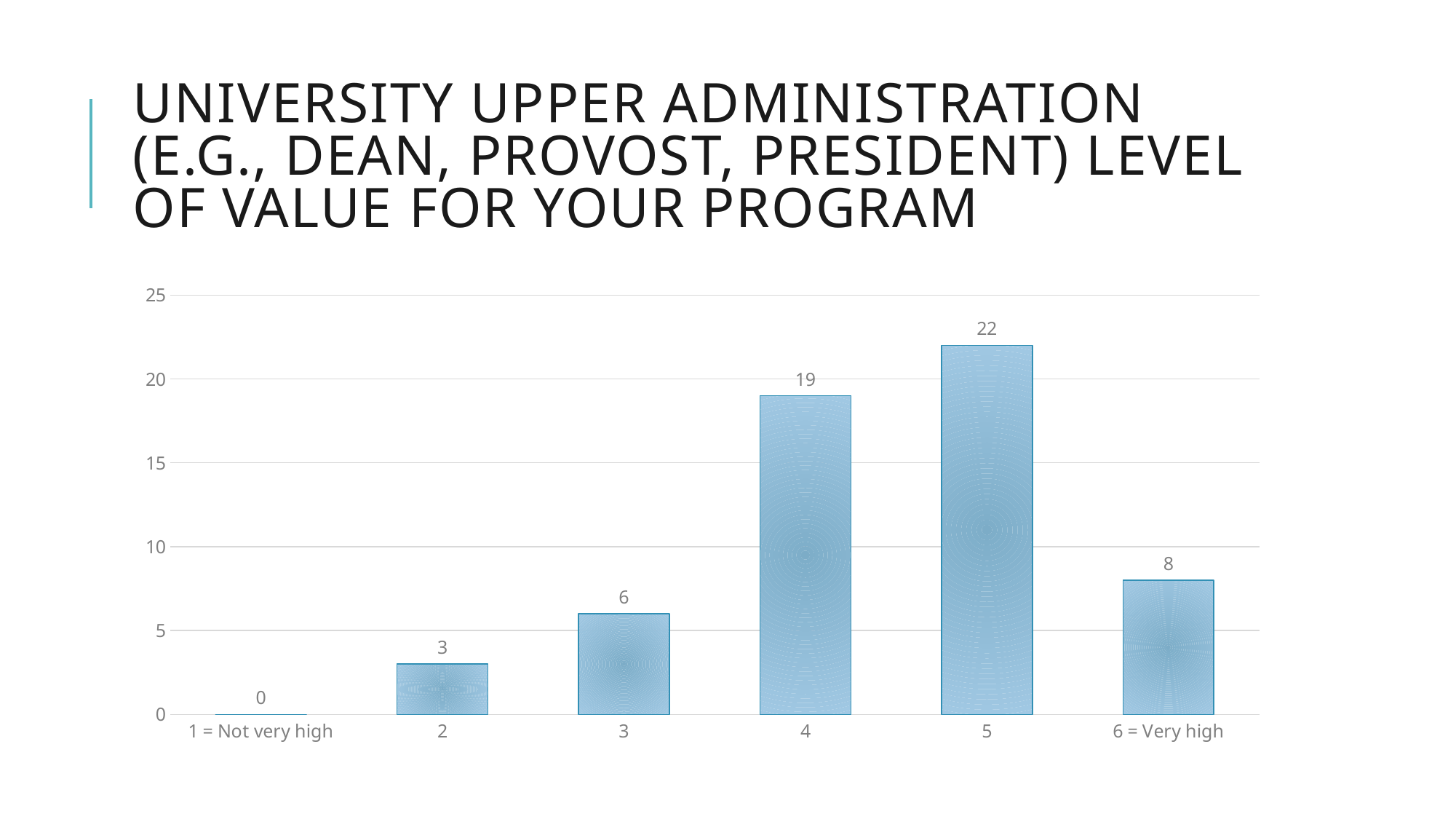
What is the value for '1 = Not very high'? 0 Which category has the highest value? 5 How many categories are shown on the x axis? 6 Is the value for category 4 greater or less than 15? greater Which is larger, the value for category 3 or the value for '6 = Very high'? 6 = Very high What is the value for category 4? 19 What is the value for category 5? 22 What is the value for '6 = Very high'? 8 What is the difference between the values for category 5 and category 4? 3 What kind of chart is shown on the slide? Bar chart What is the difference between the values for category 3 and category 2? 3 Which category has the lowest value? 1 = Not very high